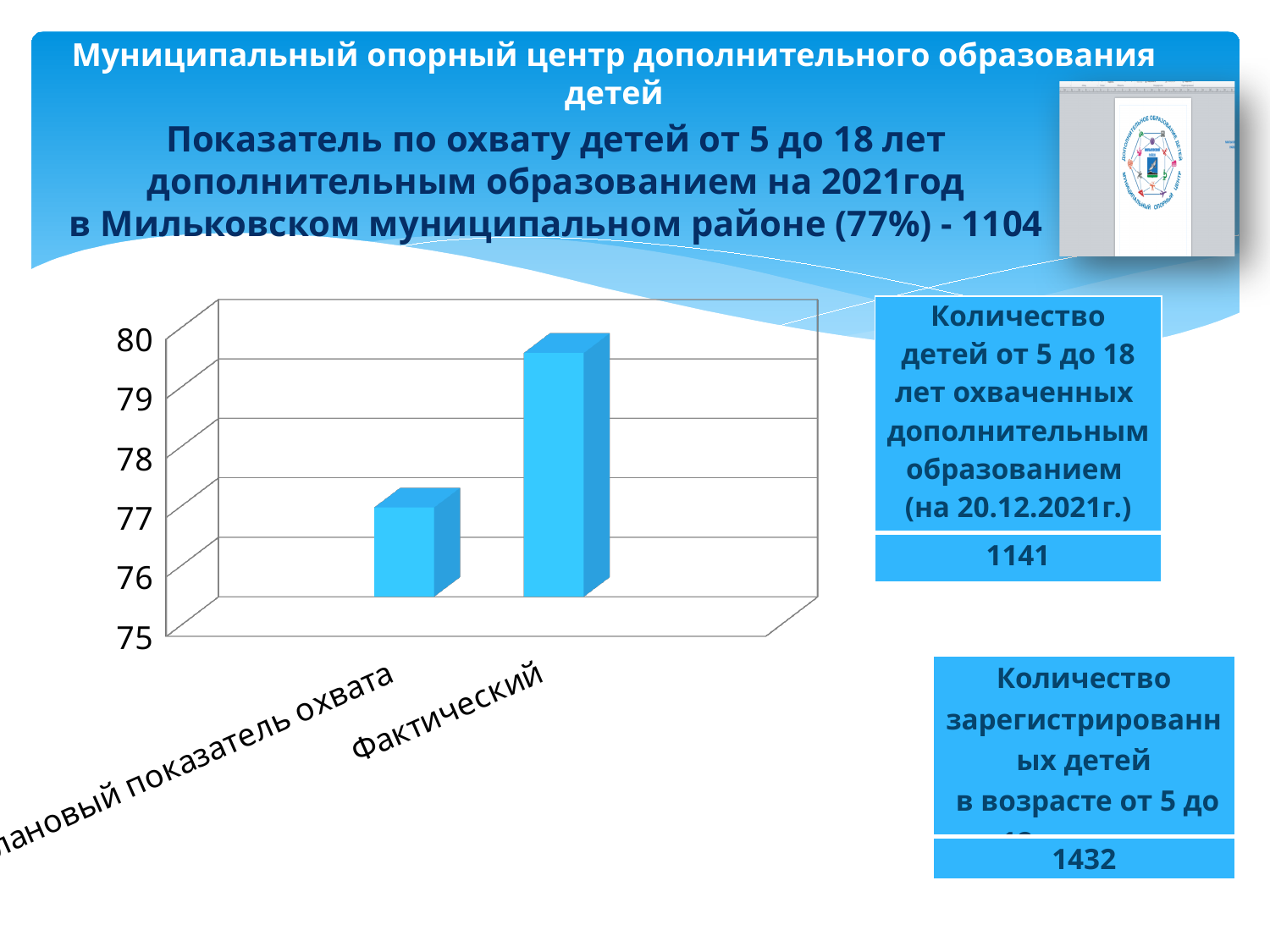
Is the value for Плановый показатель охвата greater or less than 76? greater What is the lowest value shown on the vertical axis of the chart? 75 Is the value for Фактический greater or less than 80? less How many bars are plotted in the chart? 2 Do the bar values rise or fall from left to right along the x axis? rise What kind of chart is shown on the slide? bar chart Which is larger in the chart: the value for Фактический or the value for Плановый показатель охвата? Фактический What is the highest value shown on the vertical axis of the chart? 80 Which category has the lowest bar in the chart? Плановый показатель охвата Which category has the highest bar in the chart? Фактический Is the value for Плановый показатель охвата greater or less than 78? less